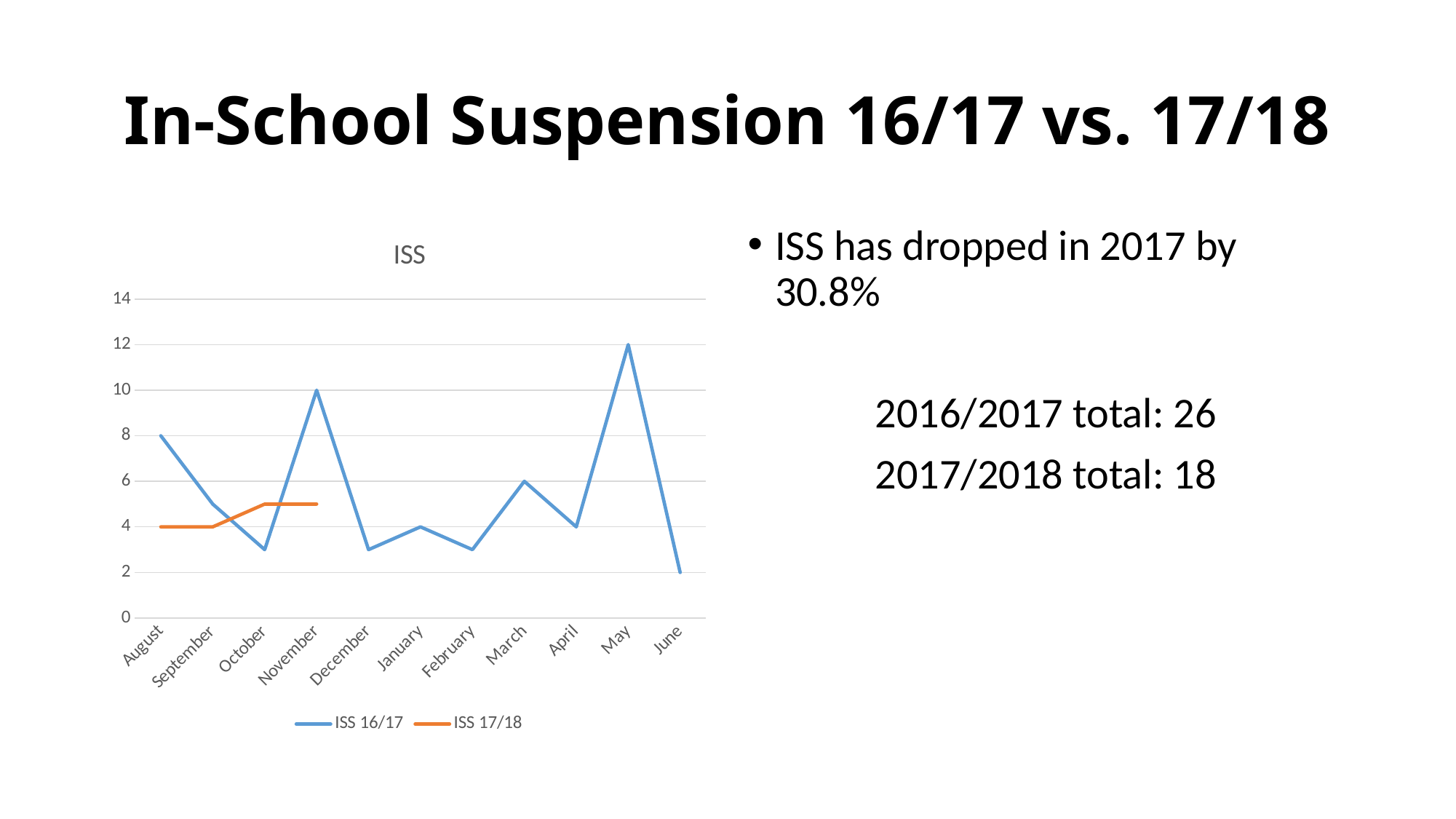
How many months are shown on the x axis? 11 In which month is ISS 16/17 at its lowest? June How many series does the legend list? 2 In which month does ISS 16/17 reach its highest value? May What kind of chart is shown on the slide? line chart What is the value of ISS 17/18 in August? 4 Is the value for ISS 17/18 in November greater or less than 4? greater What is the value of ISS 16/17 in August? 8 What is the value of ISS 16/17 in May? 12 Which is larger for ISS 16/17: the value in November or the value in August? November What is the difference between the ISS 16/17 values in May and June? 10 What is the title of the chart? ISS